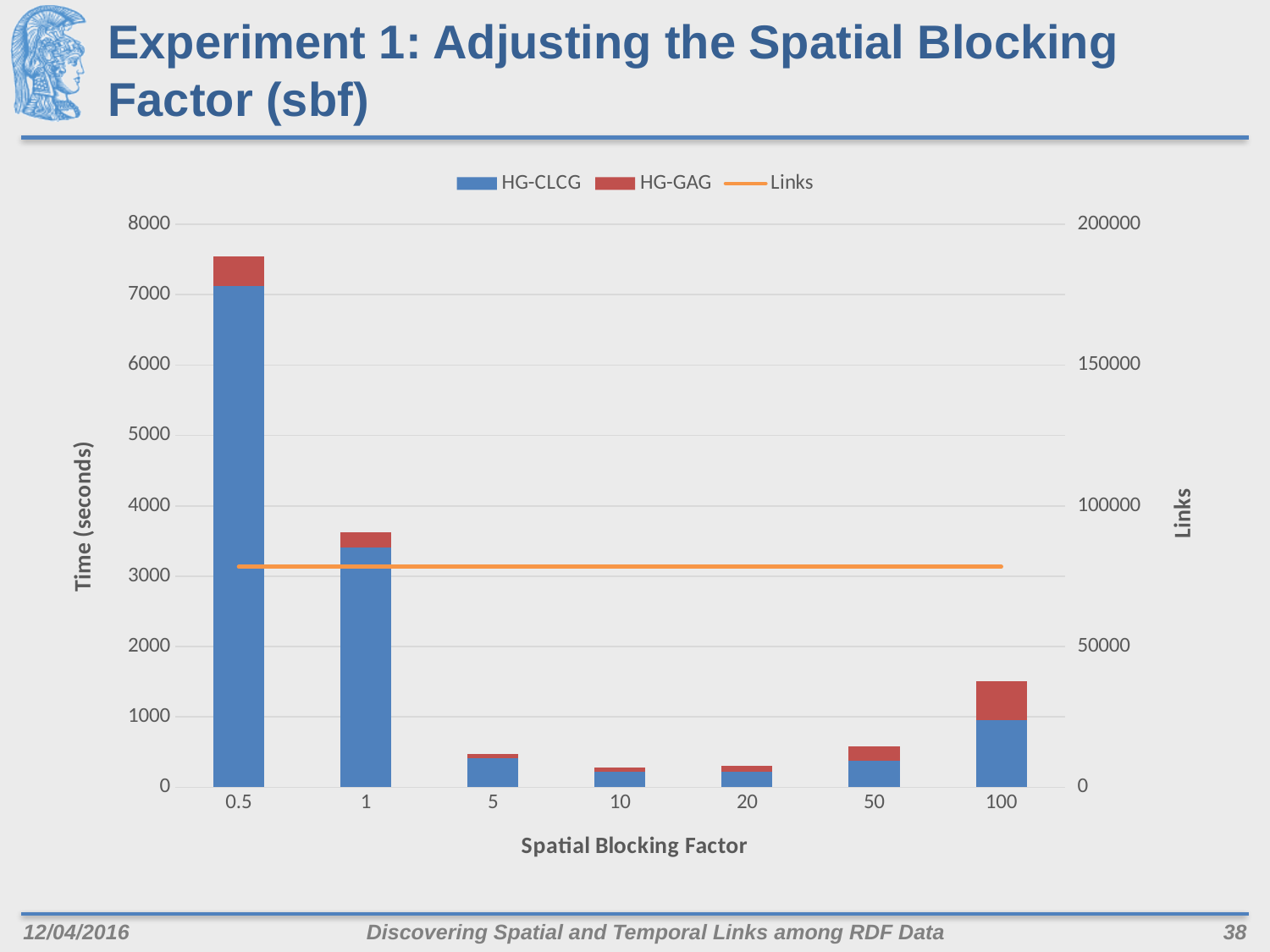
How many spatial blocking factor values are shown on the x axis? 7 Is the total time for spatial blocking factor 100 greater or less than 1000 seconds? greater What kind of chart is shown on the slide? combination stacked bar and line chart How many series does the legend list? 3 Is the total time for spatial blocking factor 0.5 greater or less than 7000 seconds? greater Which spatial blocking factor has the highest total time? 0.5 What is the label of the left vertical axis? Time (seconds) Is the total time for spatial blocking factor 5 greater or less than 1000 seconds? less Does the Links line rise, fall, or stay flat across the spatial blocking factors? stays flat Which series is plotted as a line rather than bars? Links Which has a larger total time, spatial blocking factor 1 or spatial blocking factor 100? 1